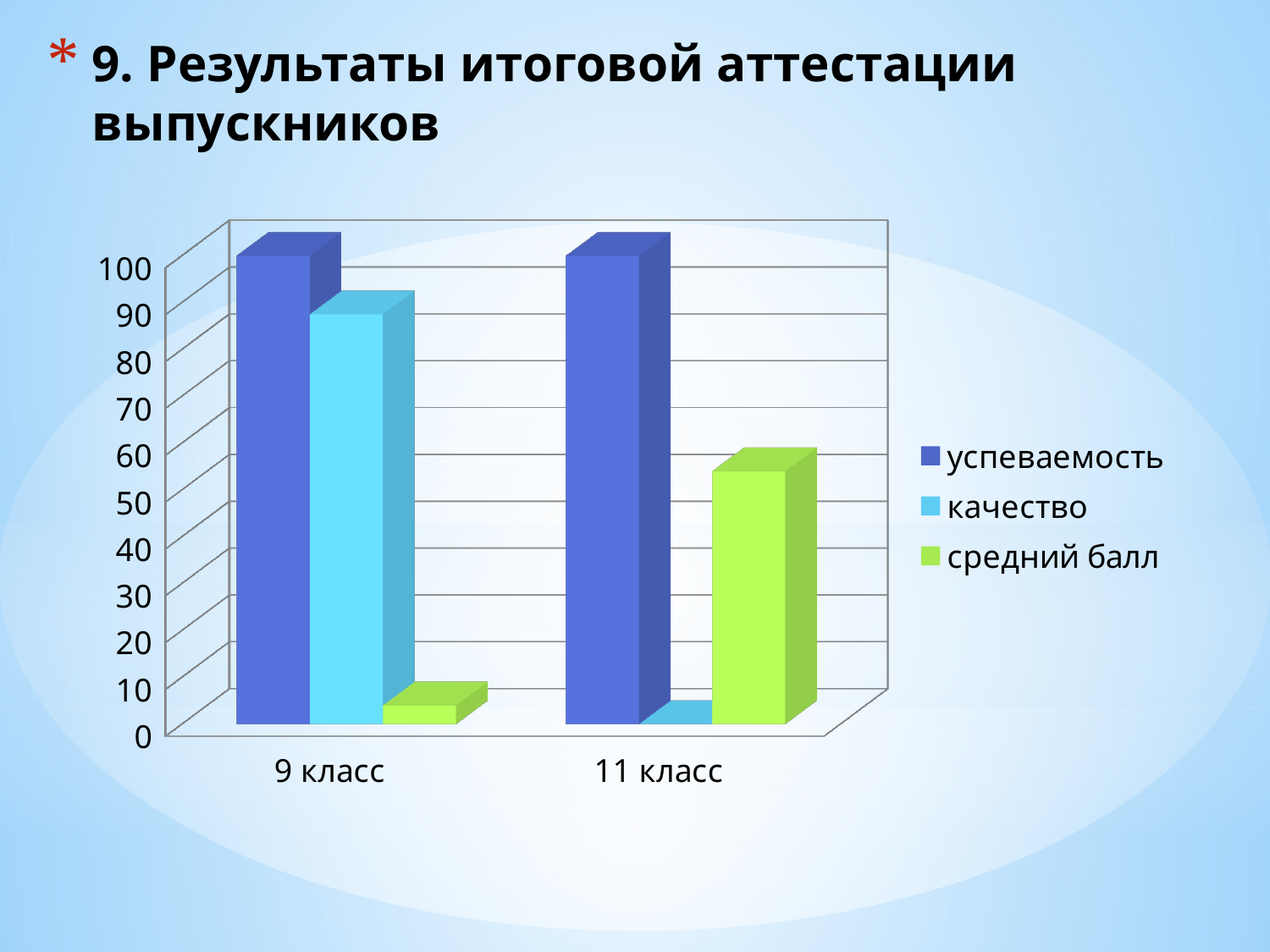
Which is larger: качество for 9 класс or качество for 11 класс? 9 класс What kind of chart is shown on the slide? bar chart Is the value of качество for 9 класс greater or less than 80? greater Which series has the lowest value for 11 класс? качество Which series has the highest value for 9 класс? успеваемость Is the value of средний балл for 9 класс greater or less than 10? less How many categories are shown on the x axis of the chart? 2 Which series is shown in light blue in the chart? качество Is the value of качество for 11 класс greater or less than 10? less Which series is shown in green in the chart? средний балл How many series does the chart legend list? 3